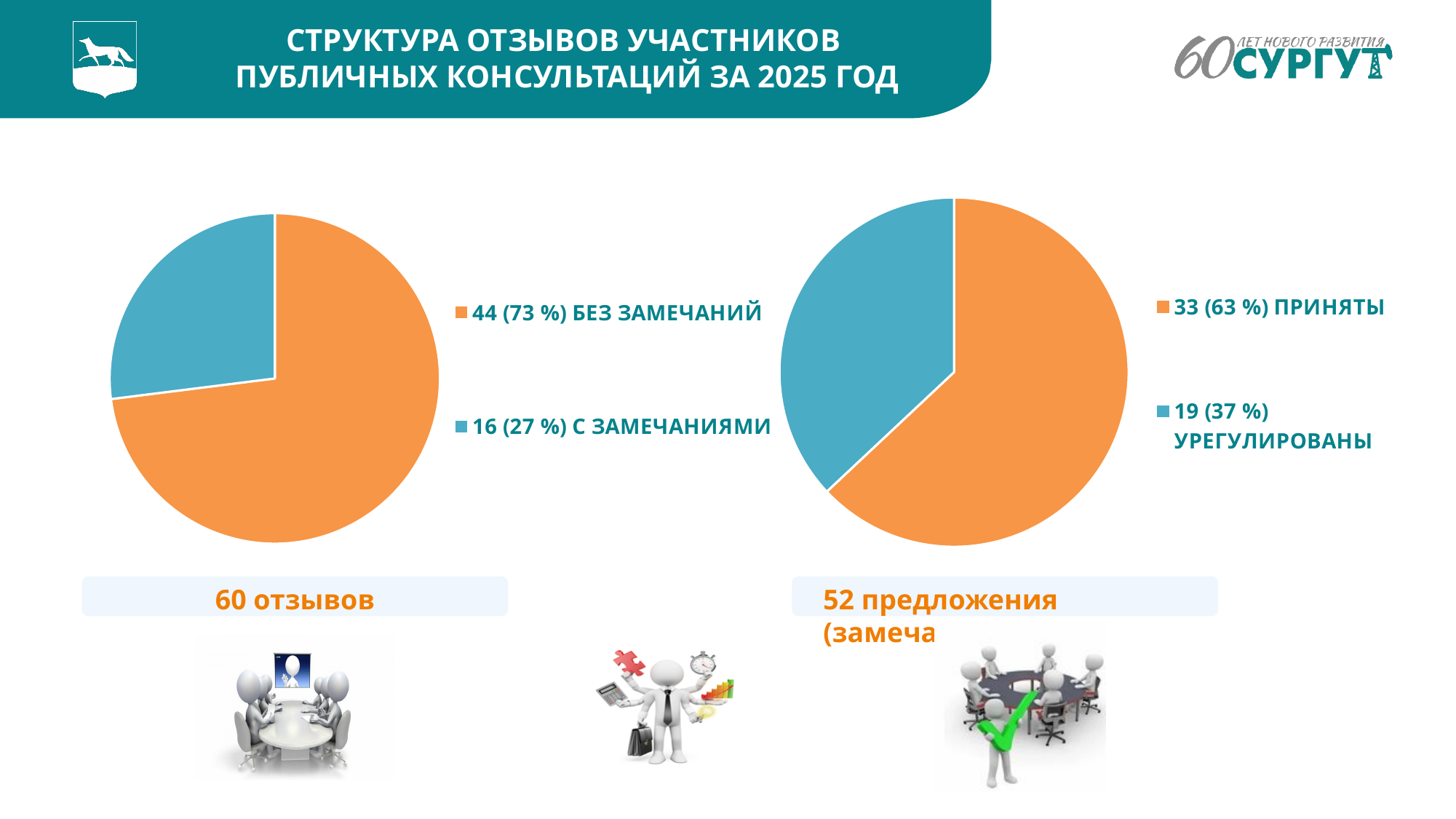
How many slices does the left pie chart have? 2 In the left pie chart, what colour is the БЕЗ ЗАМЕЧАНИЙ slice? Orange In the right pie chart, what is the total of the two slices (33 and 19)? 52 In the left pie chart, how many reviews are labelled БЕЗ ЗАМЕЧАНИЙ? 44 In the right pie chart, is the ПРИНЯТЫ value larger or smaller than the УРЕГУЛИРОВАНЫ value? Larger In the left pie chart, which category has the largest slice? БЕЗ ЗАМЕЧАНИЙ In the right pie chart, what percentage share is labelled УРЕГУЛИРОВАНЫ? 37 % In the right pie chart, how many proposals are labelled ПРИНЯТЫ? 33 In the right pie chart, which category has the smallest slice? УРЕГУЛИРОВАНЫ In the left pie chart, what is the difference between the БЕЗ ЗАМЕЧАНИЙ count and the С ЗАМЕЧАНИЯМИ count? 28 In the left pie chart, what percentage share is labelled С ЗАМЕЧАНИЯМИ? 27 % What type of chart is shown on the left side of the slide? Pie chart